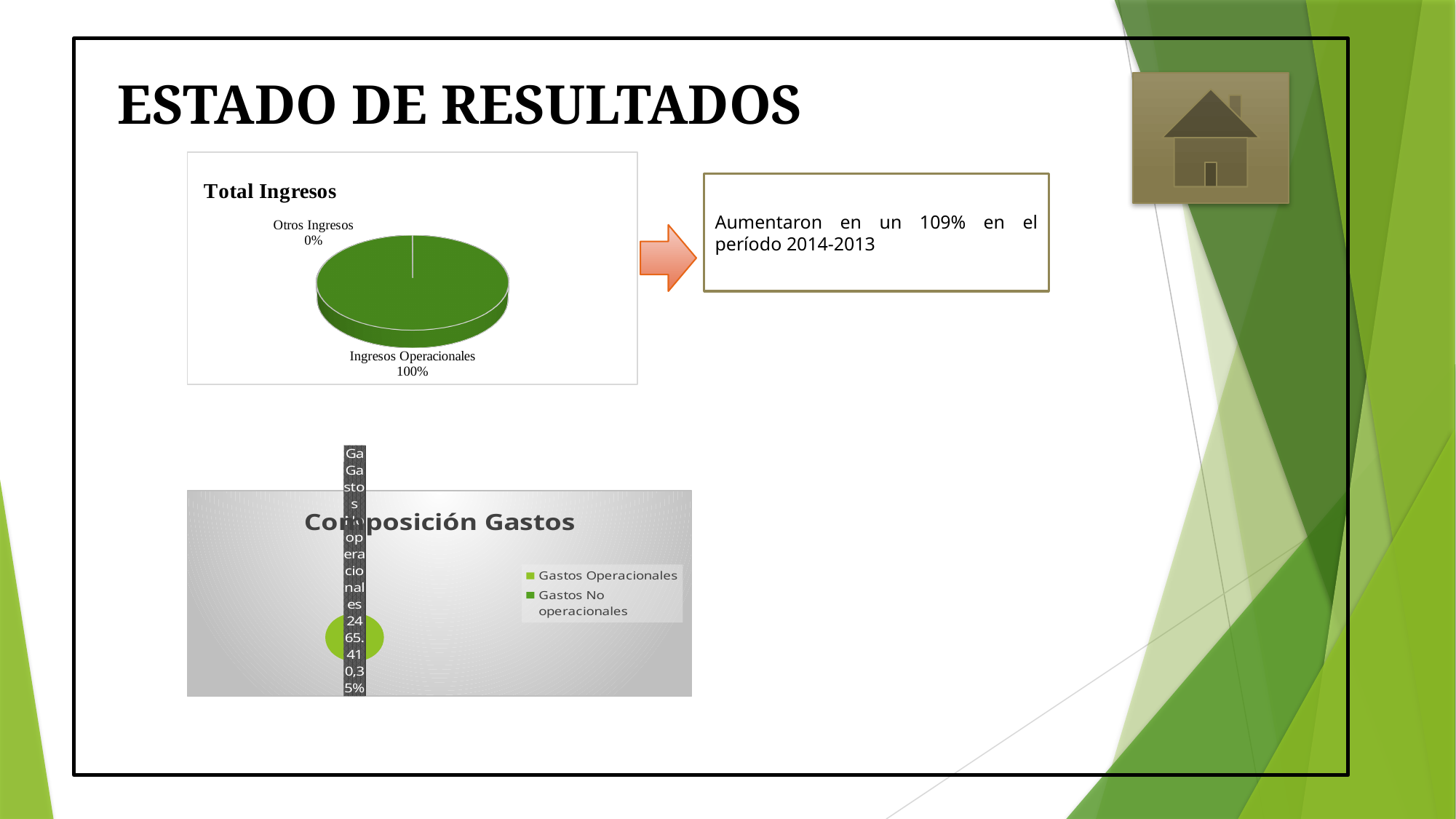
In the 'Total Ingresos' chart, which category has the smallest share? Otros Ingresos How many categories are labelled in the 'Total Ingresos' chart? 2 In the 'Total Ingresos' chart, which is larger, Ingresos Operacionales or Otros Ingresos? Ingresos Operacionales What kind of chart is the 'Total Ingresos' chart? Pie chart In the 'Total Ingresos' chart, which category has the largest share? Ingresos Operacionales In the 'Total Ingresos' chart, what is the difference between the shares of Ingresos Operacionales and Otros Ingresos? 100% What is the title of the chart at the top left of the slide? Total Ingresos In the 'Total Ingresos' chart, what share does Ingresos Operacionales have? 100% How many series does the legend of the 'Composición Gastos' chart list? 2 What kind of chart is the 'Composición Gastos' chart? Pie chart What are the two legend entries in the 'Composición Gastos' chart? Gastos Operacionales and Gastos No operacionales In the 'Total Ingresos' chart, what share does Otros Ingresos have? 0%